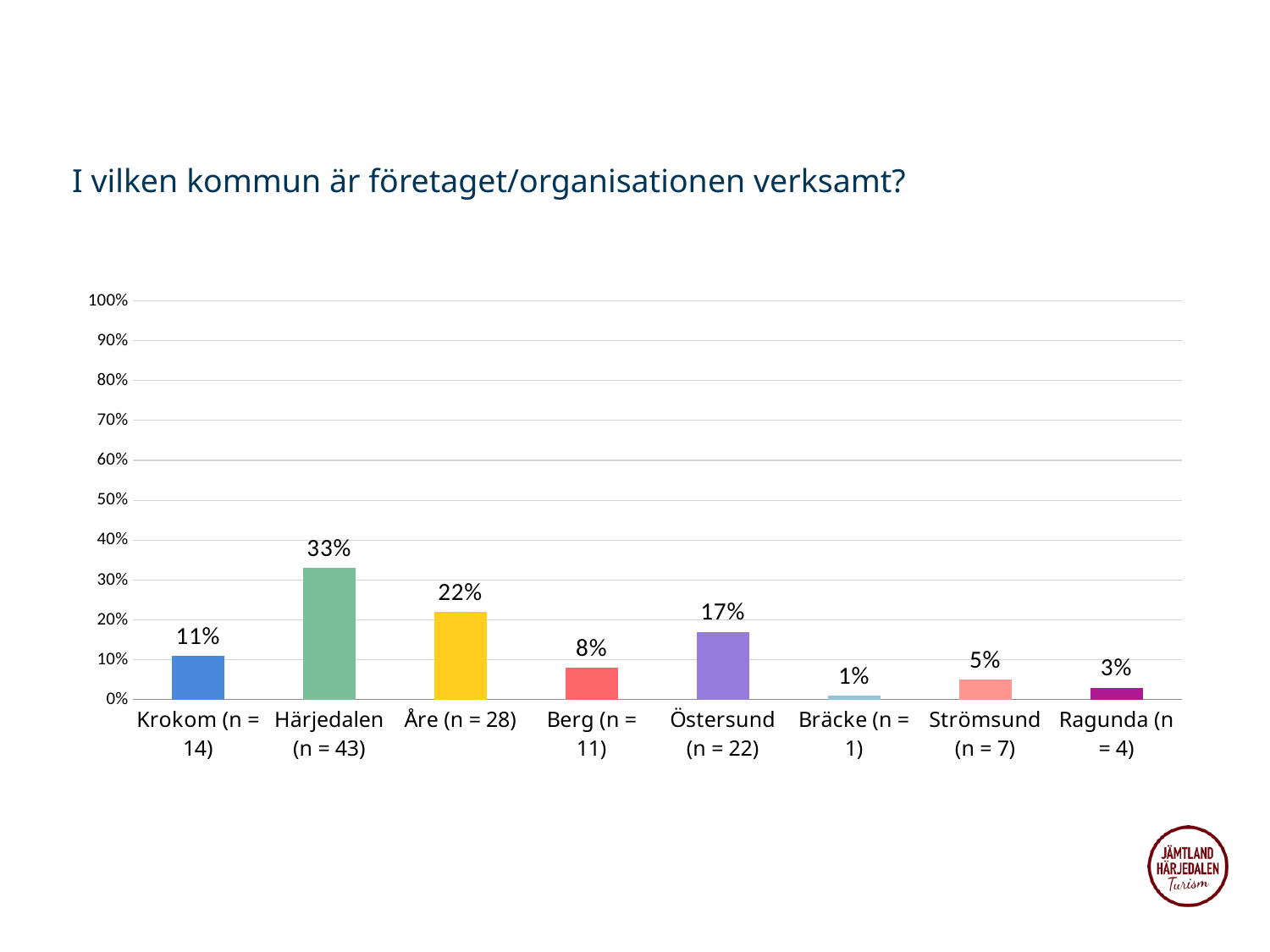
What kind of chart is shown on the slide? bar chart What is the value for Strömsund (n = 7)? 5% What is the title of the slide? I vilken kommun är företaget/organisationen verksamt? Which municipality has the lowest value? Bräcke (n = 1) Is the value for Åre (n = 28) greater or less than 20%? greater What is the value for Östersund (n = 22)? 17% Which municipality has the highest value? Härjedalen (n = 43) Which is larger, the value for Berg (n = 11) or the value for Östersund (n = 22)? Östersund (n = 22) What is the difference between the values for Krokom (n = 14) and Ragunda (n = 4)? 8% What is the value for Härjedalen (n = 43)? 33% What is the difference between the values for Härjedalen (n = 43) and Åre (n = 28)? 11% How many municipalities are shown on the chart? 8